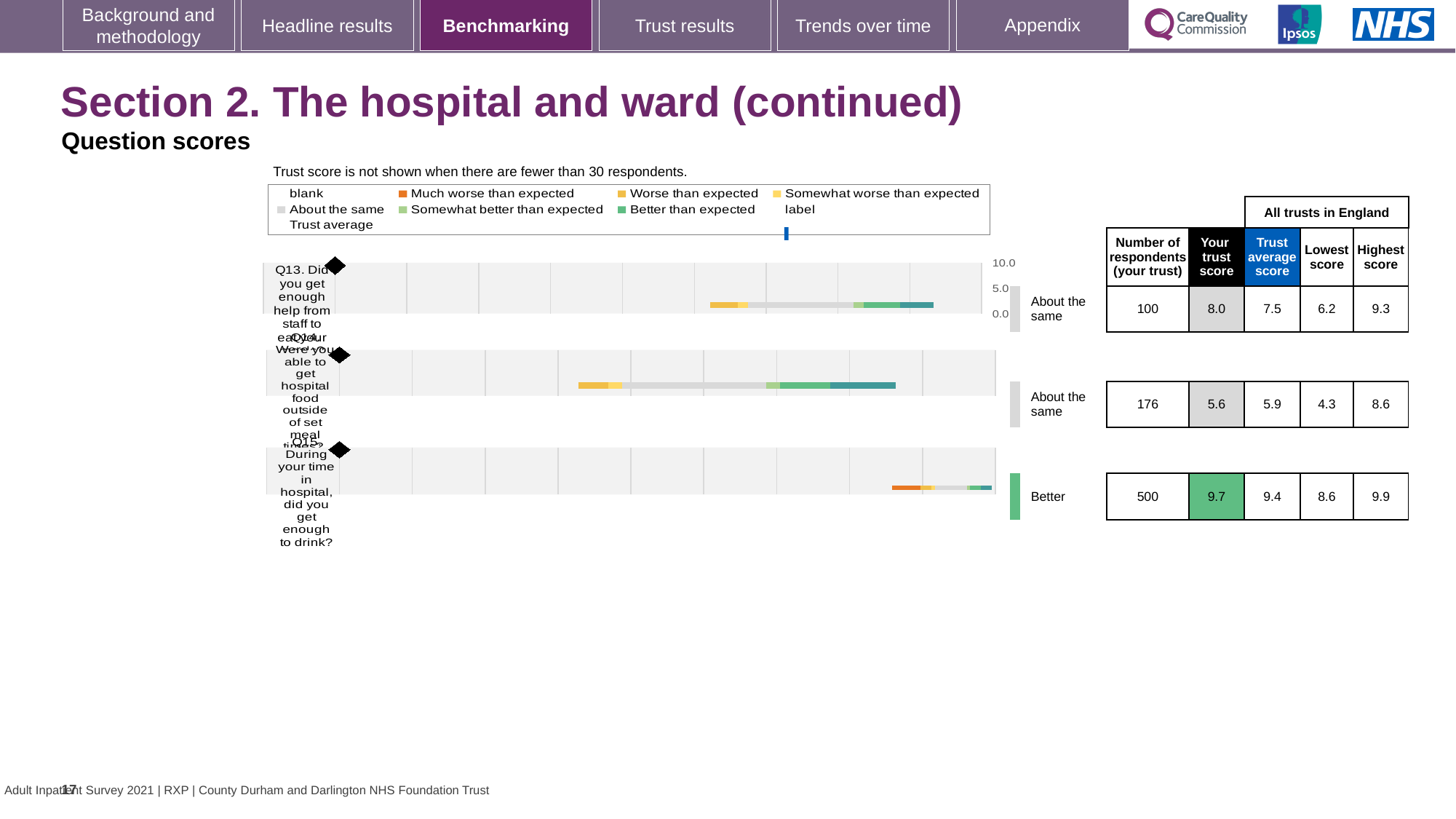
Which question has the lowest 'Your trust score'? Q14 Which question has the highest 'Your trust score'? Q15 What colour does the legend use for 'Much worse than expected'? Orange How many respondents does the table show for Q15 (did you get enough to drink)? 500 How many questions are plotted in the chart on this slide? 3 What benchmark category is shown next to the bar for Q15? Better What is the difference between the highest score and the lowest score for Q14? 4.3 For Q15, how much higher is the trust score (9.7) than the trust average score (9.4)? 0.3 What kind of chart is used to show the question scores on this slide? Bar chart What is the 'Your trust score' value for Q13 (Did you get enough help from staff to eat your meals)? 8.0 What is the trust average score for Q14 (Were you able to get hospital food outside of set meal times)? 5.9 For Q13, which is larger: the trust score or the trust average score? The trust score (8.0)